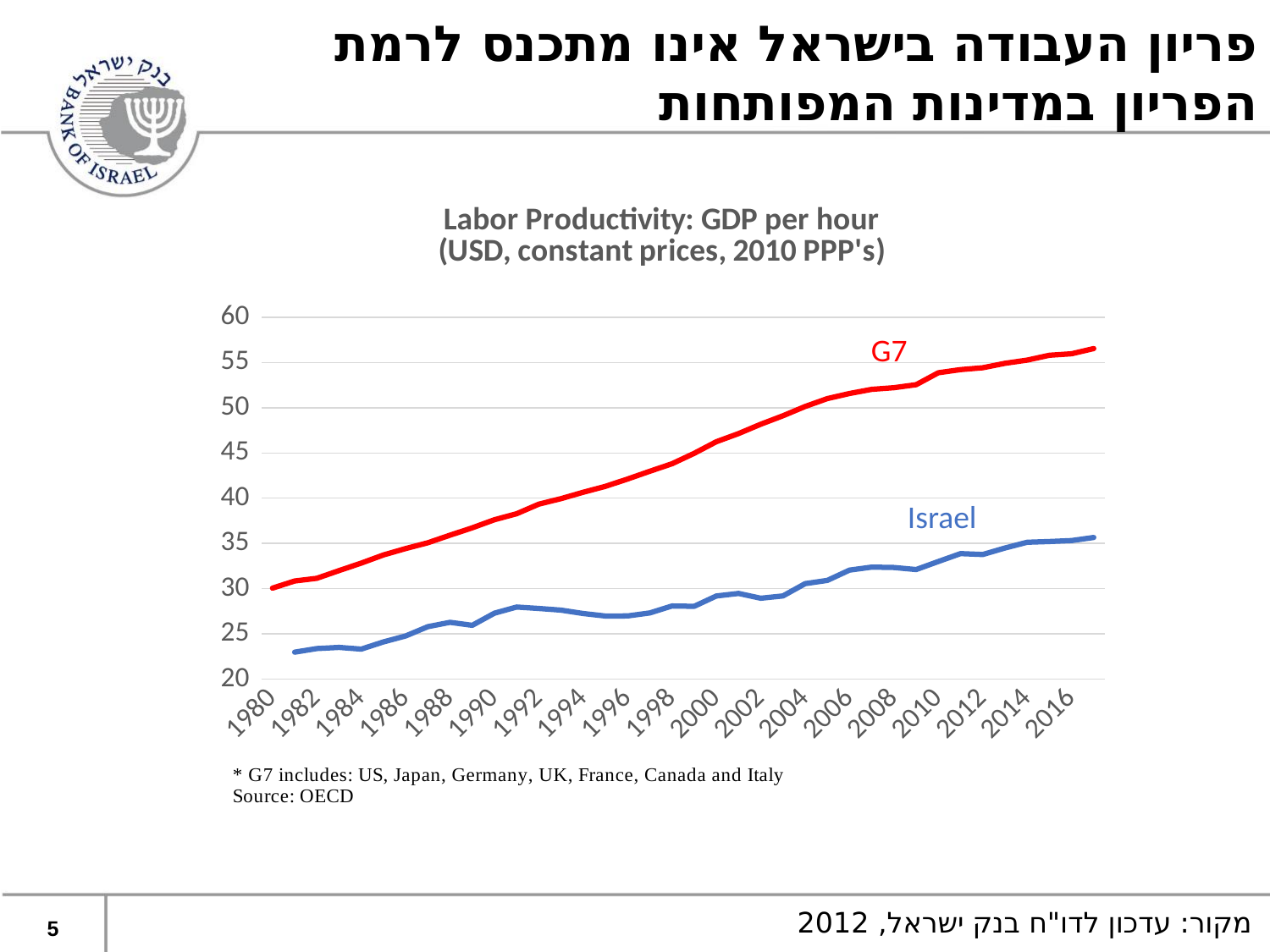
What colour is the Israel line? Blue Which series is higher throughout the whole period, G7 or Israel? G7 What kind of chart is shown on the slide? Line chart Is the value for G7 in 2000 greater or less than 40? greater Which series has the higher value in 2016, G7 or Israel? G7 Is the value for G7 in 2016 greater or less than 55? greater How many series are plotted on the chart? 2 Is the value for Israel in 2000 greater or less than 30? less What is the title of the chart? Labor Productivity: GDP per hour (USD, constant prices, 2010 PPP's) Does the Israel line generally rise or fall from 1980 to 2016? Rises Does the G7 line rise or fall from 1980 to 2016? Rises